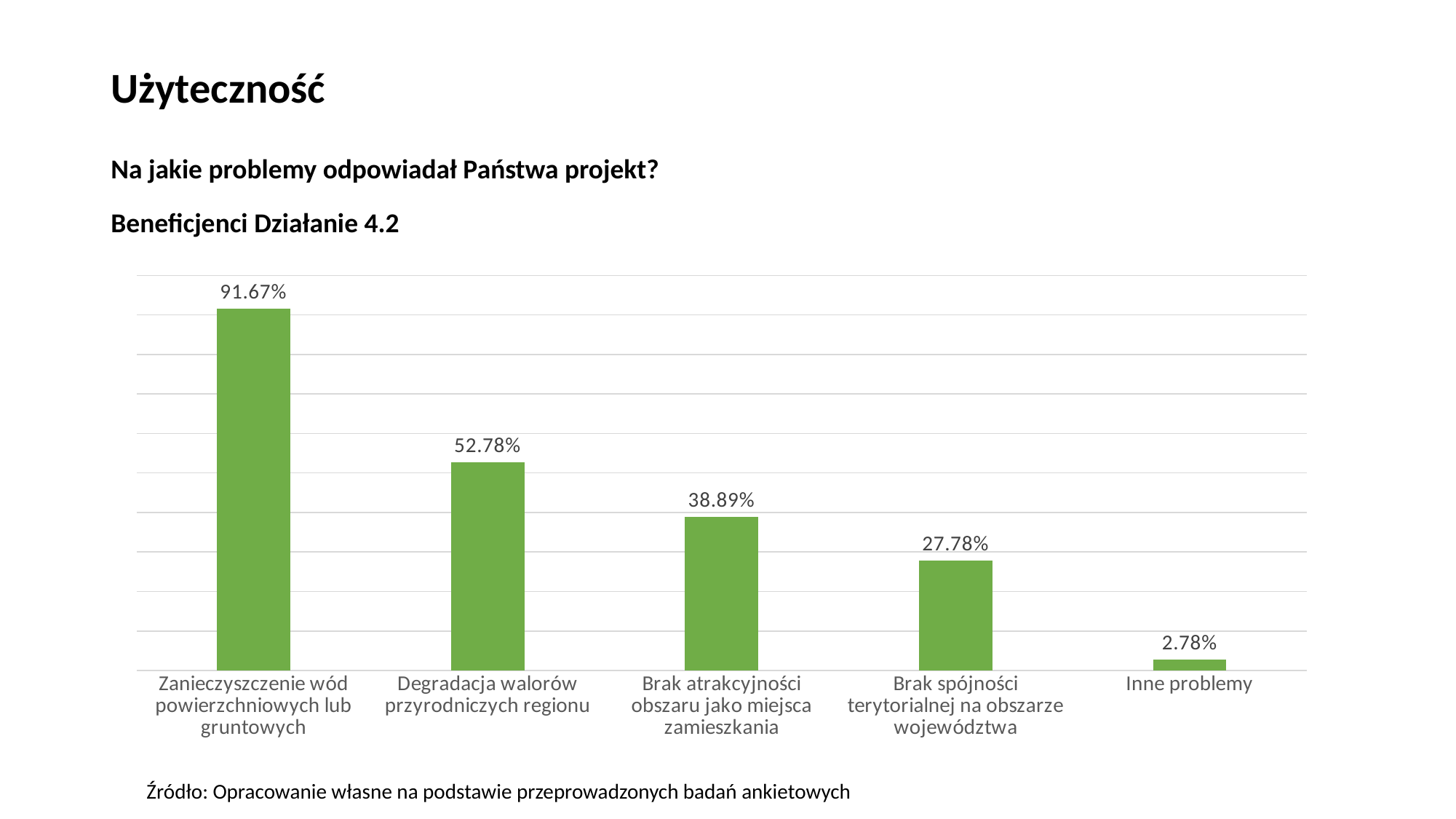
What is the value for "Degradacja walorów przyrodniczych regionu"? 52.78% Which category has the lowest value? Inne problemy What is the difference between the values for "Zanieczyszczenie wód powierzchniowych lub gruntowych" and "Degradacja walorów przyrodniczych regionu"? 38.89% Do the values rise or fall from left to right along the x axis? Fall Which category has the highest value? Zanieczyszczenie wód powierzchniowych lub gruntowych What kind of chart is shown on the slide? Bar chart What is the value for "Inne problemy"? 2.78% How many categories are shown in the chart? 5 What is the value for "Brak spójności terytorialnej na obszarze województwa"? 27.78% What is the value for "Brak atrakcyjności obszaru jako miejsca zamieszkania"? 38.89% What is the value for "Zanieczyszczenie wód powierzchniowych lub gruntowych"? 91.67% Which is larger: the value for "Brak atrakcyjności obszaru jako miejsca zamieszkania" or for "Brak spójności terytorialnej na obszarze województwa"? Brak atrakcyjności obszaru jako miejsca zamieszkania